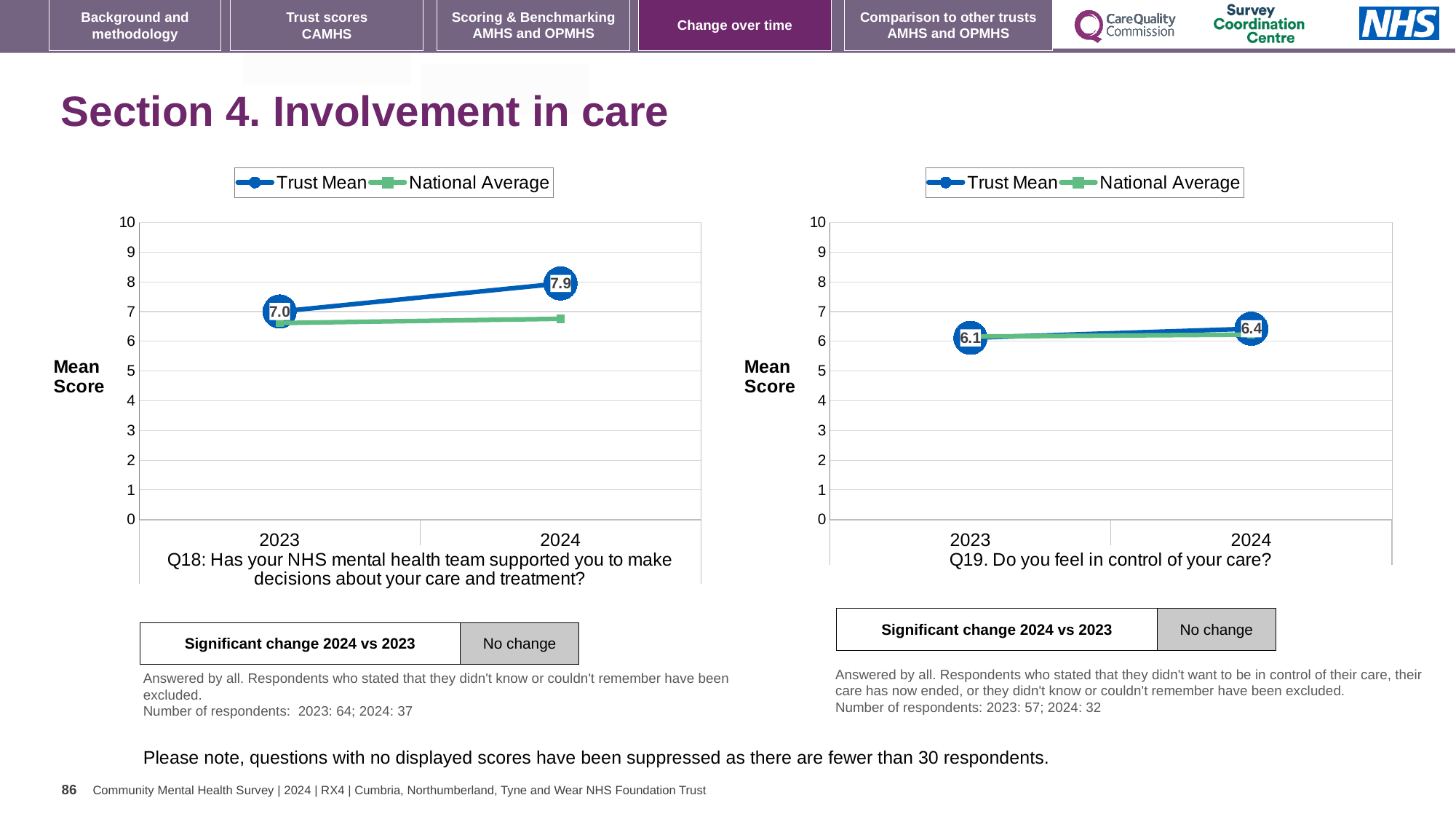
How many series does the legend of the Q19 chart list? 2 What type of chart is used for Q18? line chart In the Q18 chart, what is the Trust Mean score for 2024? 7.9 In the Q19 chart, what is the Trust Mean score for 2023? 6.1 In the Q18 chart, what is the Trust Mean score for 2023? 7.0 In the Q18 chart, is the National Average for 2024 greater or less than 7? less In the Q18 chart, which is higher in 2024, the Trust Mean or the National Average? Trust Mean How many years are plotted on the x axis of the Q19 chart? 2 In the Q18 chart, does the Trust Mean rise or fall from 2023 to 2024? rise In the Q19 chart, what is the Trust Mean score for 2024? 6.4 In the Q19 chart, what is the difference between the Trust Mean in 2024 and 2023? 0.3 In the Q18 chart, by how much did the Trust Mean change from 2023 to 2024? 0.9